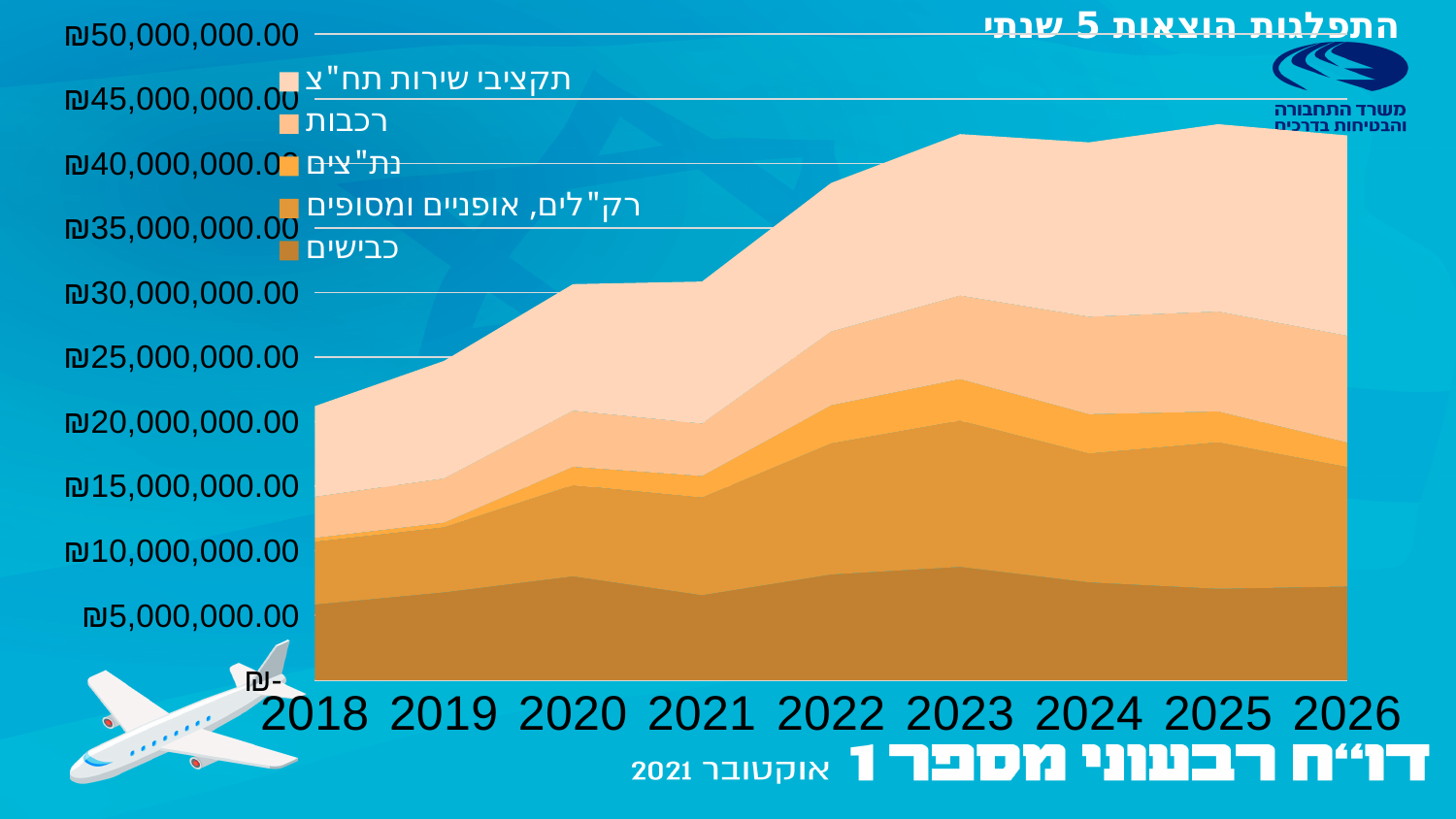
Is the total expenditure for 2018 greater or less than ₪20,000,000.00? greater How many series does the chart's legend list? 5 Which year has the lowest total expenditure in the chart? 2018 Is the value for כבישים in 2018 greater or less than ₪5,000,000.00? greater What kind of chart is shown on the slide? Stacked area chart Is the total expenditure for 2023 larger or smaller than the total for 2019? larger How many years are shown along the x axis of the chart? 9 Which series is listed last in the chart's legend? כבישים Does the total expenditure generally rise or fall from 2018 to 2025? Rise What is the title of the chart? התפלגות הוצאות 5 שנתי Is the total expenditure for 2023 greater or less than ₪40,000,000.00? greater